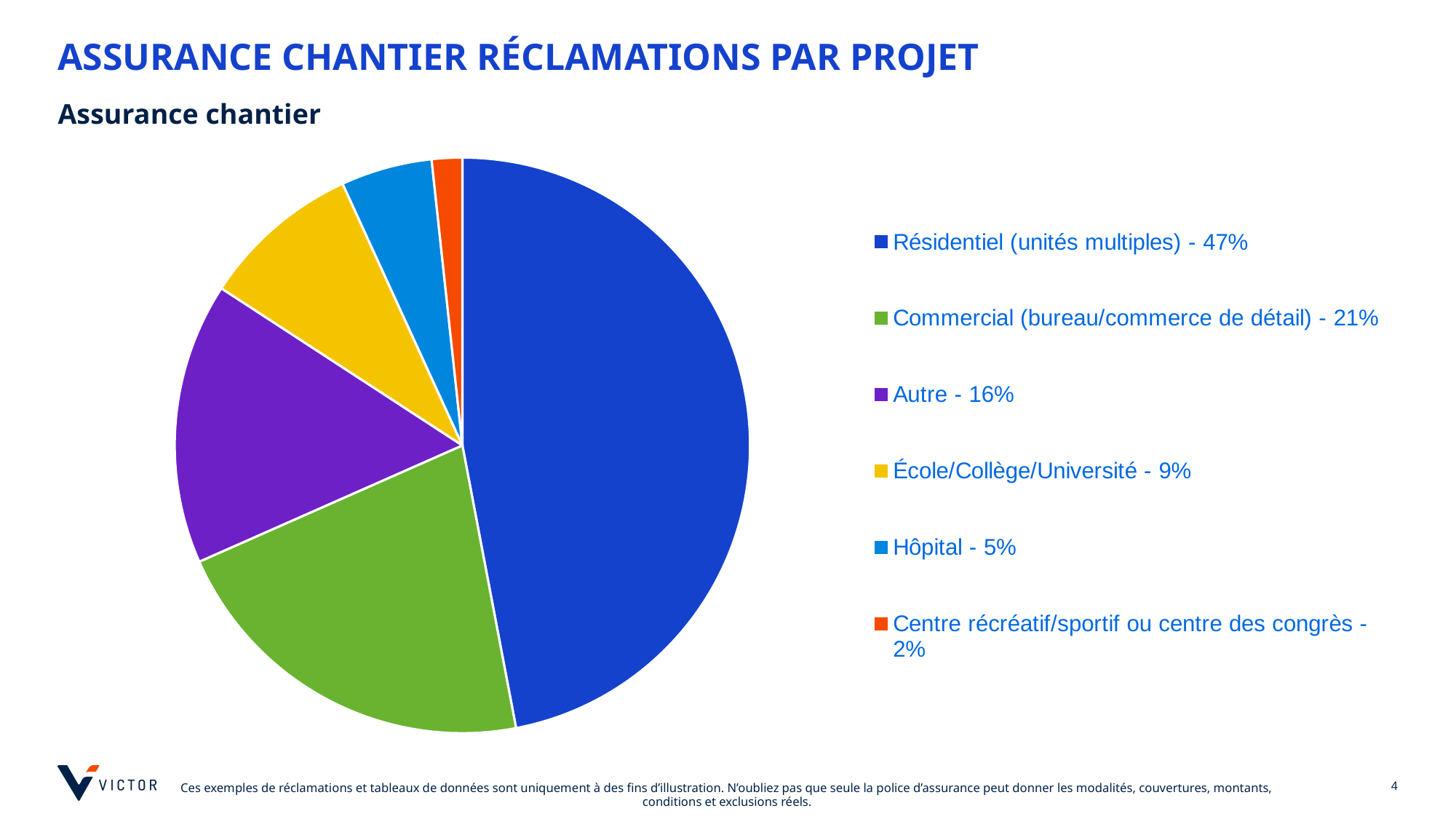
Which category has the largest share of claims? Résidentiel (unités multiples) How many categories does the pie chart show? 6 What is the difference in percentage points between Résidentiel (unités multiples) and Commercial (bureau/commerce de détail)? 26 What share of claims is attributed to Résidentiel (unités multiples)? 47% Which category has the smallest share of claims? Centre récréatif/sportif ou centre des congrès Which has a larger share: Autre or École/Collège/Université? Autre What share of claims is attributed to École/Collège/Université? 9% What share of claims is attributed to Commercial (bureau/commerce de détail)? 21% What colour is the slice for Autre? purple What kind of chart is shown on the slide? pie chart What share of claims is attributed to Hôpital? 5% What is the combined share of Hôpital and Centre récréatif/sportif ou centre des congrès? 7%